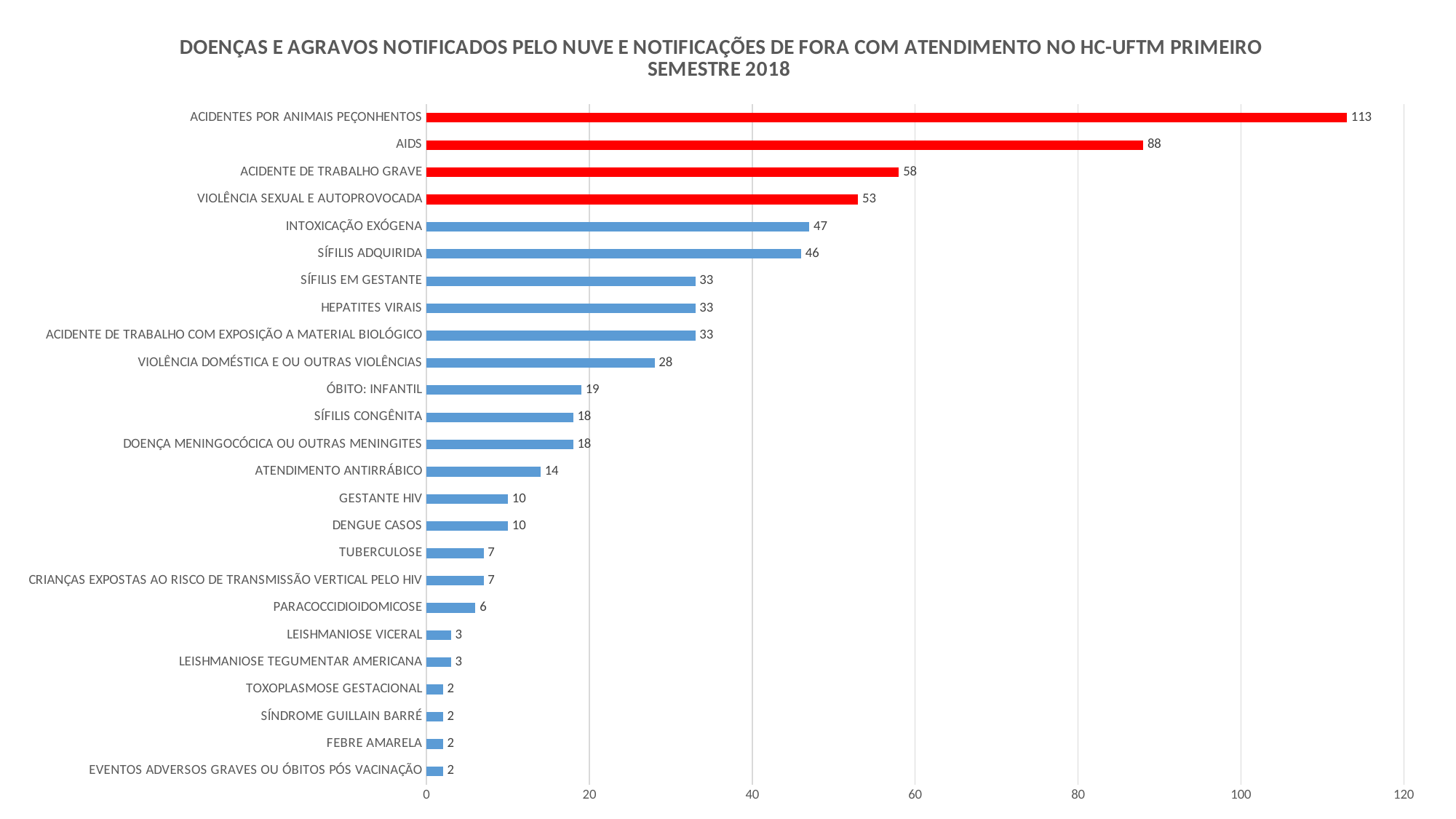
Which category has the highest value? ACIDENTES POR ANIMAIS PEÇONHENTOS What is the difference between the values for ACIDENTES POR ANIMAIS PEÇONHENTOS and AIDS? 25 Is the value for ÓBITO: INFANTIL greater or less than 20? less Which is larger, the value for SÍFILIS ADQUIRIDA or the value for VIOLÊNCIA DOMÉSTICA E OU OUTRAS VIOLÊNCIAS? SÍFILIS ADQUIRIDA What kind of chart is shown on the slide? bar chart How many categories are shown in the chart? 25 What is the difference between the values for ACIDENTE DE TRABALHO GRAVE and VIOLÊNCIA SEXUAL E AUTOPROVOCADA? 5 What is the value for ATENDIMENTO ANTIRRÁBICO? 14 What is the value for INTOXICAÇÃO EXÓGENA? 47 What is the value for AIDS? 88 How many bars are coloured red? 4 What is the value for PARACOCCIDIOIDOMICOSE? 6